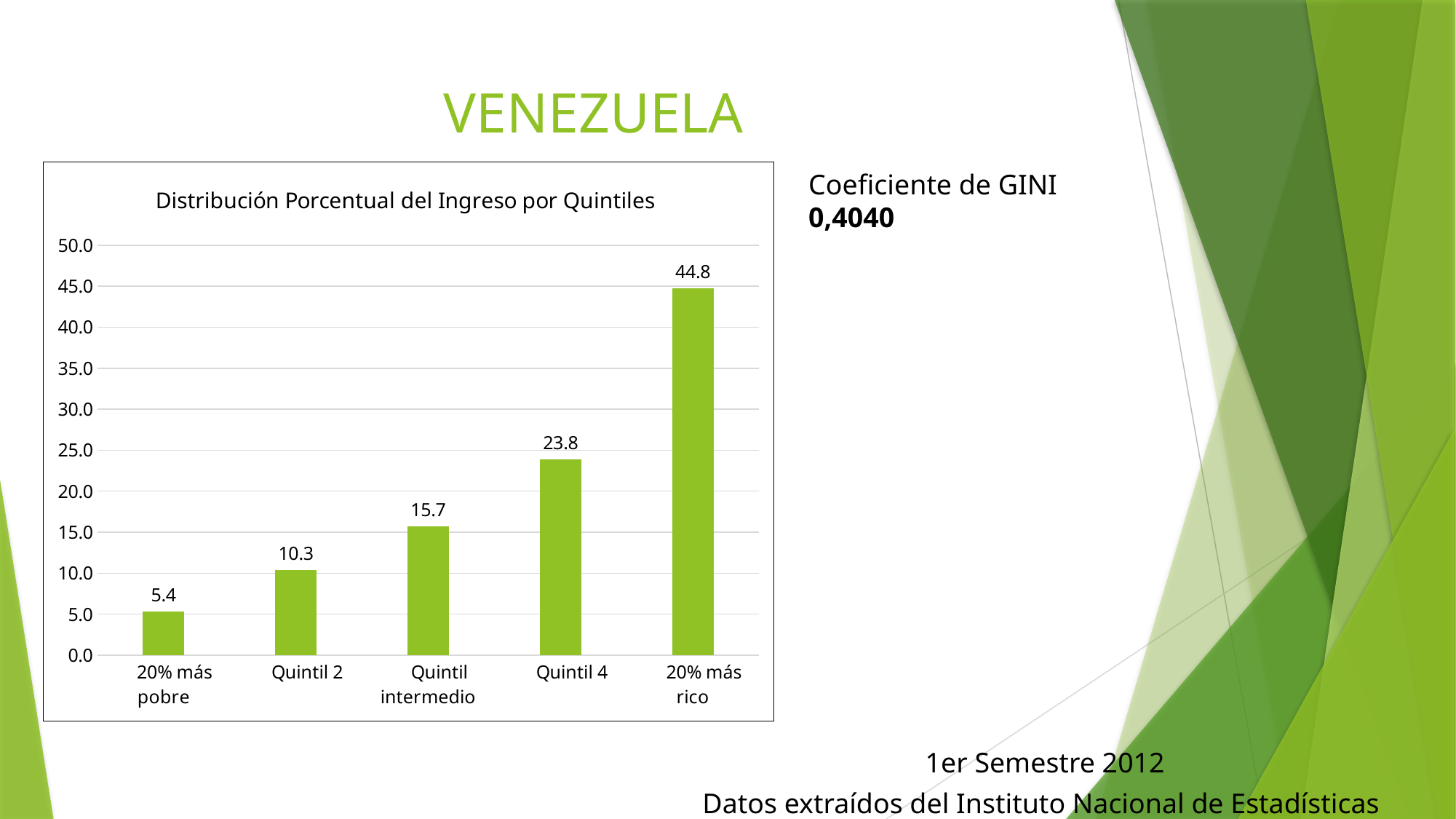
What is the difference between the values for Quintil 4 and Quintil 2? 13.5 What is the title of the chart? Distribución Porcentual del Ingreso por Quintiles How many categories are shown on the x axis? 5 Which is larger, the value for Quintil 4 or the value for Quintil intermedio? Quintil 4 Is the value for Quintil 4 greater or less than 20.0? greater What is the value for Quintil intermedio? 15.7 What kind of chart is shown on the slide? bar chart What is the difference between the values for 20% más rico and 20% más pobre? 39.4 Which category has the lowest value? 20% más pobre What is the value for 20% más rico? 44.8 Which category has the highest value? 20% más rico What is the value for Quintil 2? 10.3